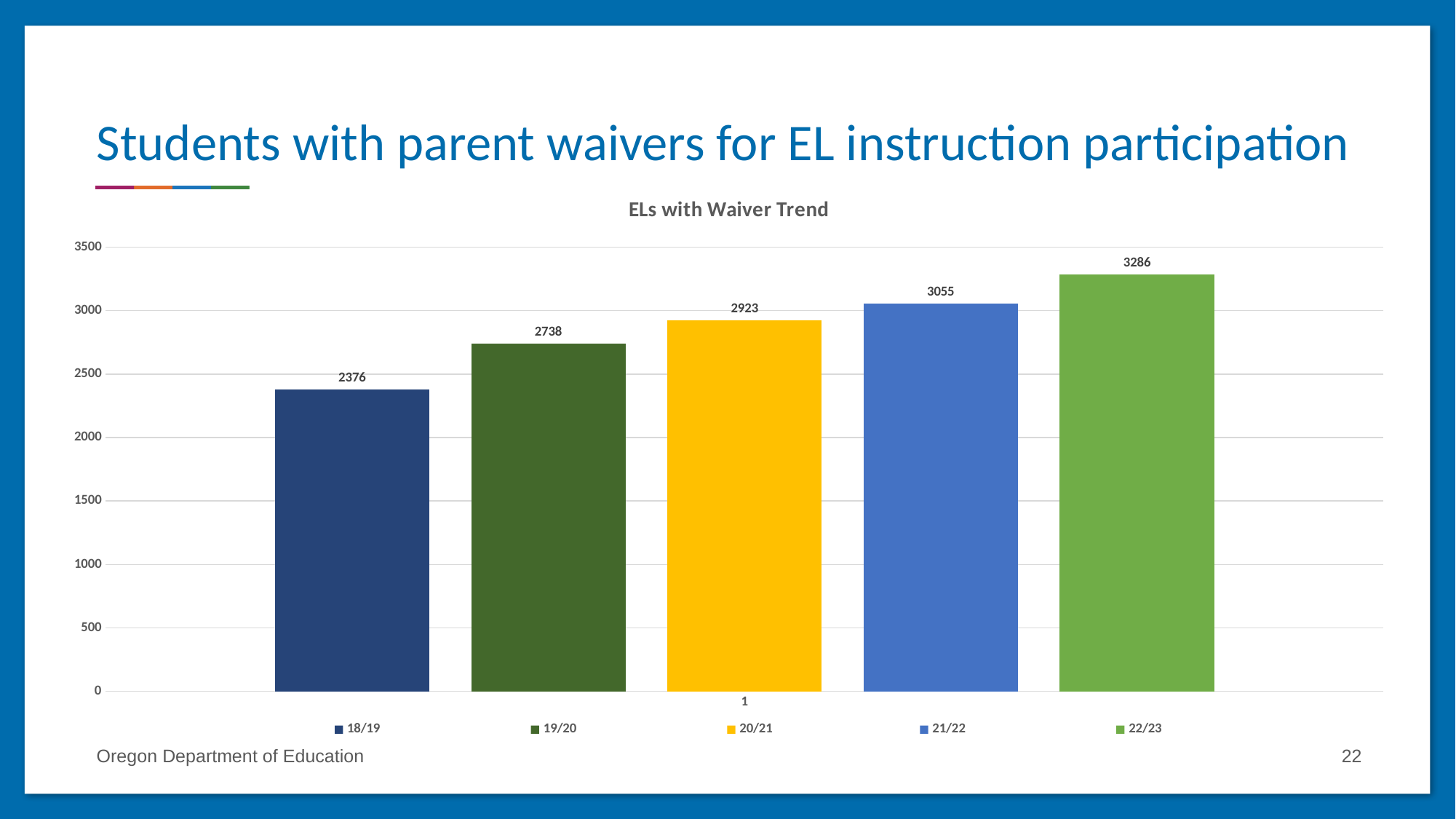
Which is larger, the value for 19/20 or the value for 21/22? 21/22 What kind of chart is shown? bar chart What is the value for 22/23? 3286 Is the value for 19/20 greater or less than 3000? less Do the values rise or fall from 18/19 to 22/23? rise What is the difference between the values for 21/22 and 20/21? 132 What is the value for 18/19? 2376 Which series has the lowest value? 18/19 What is the difference between the values for 22/23 and 18/19? 910 Which series has the highest value? 22/23 What is the value for 20/21? 2923 How many series does the legend list? 5